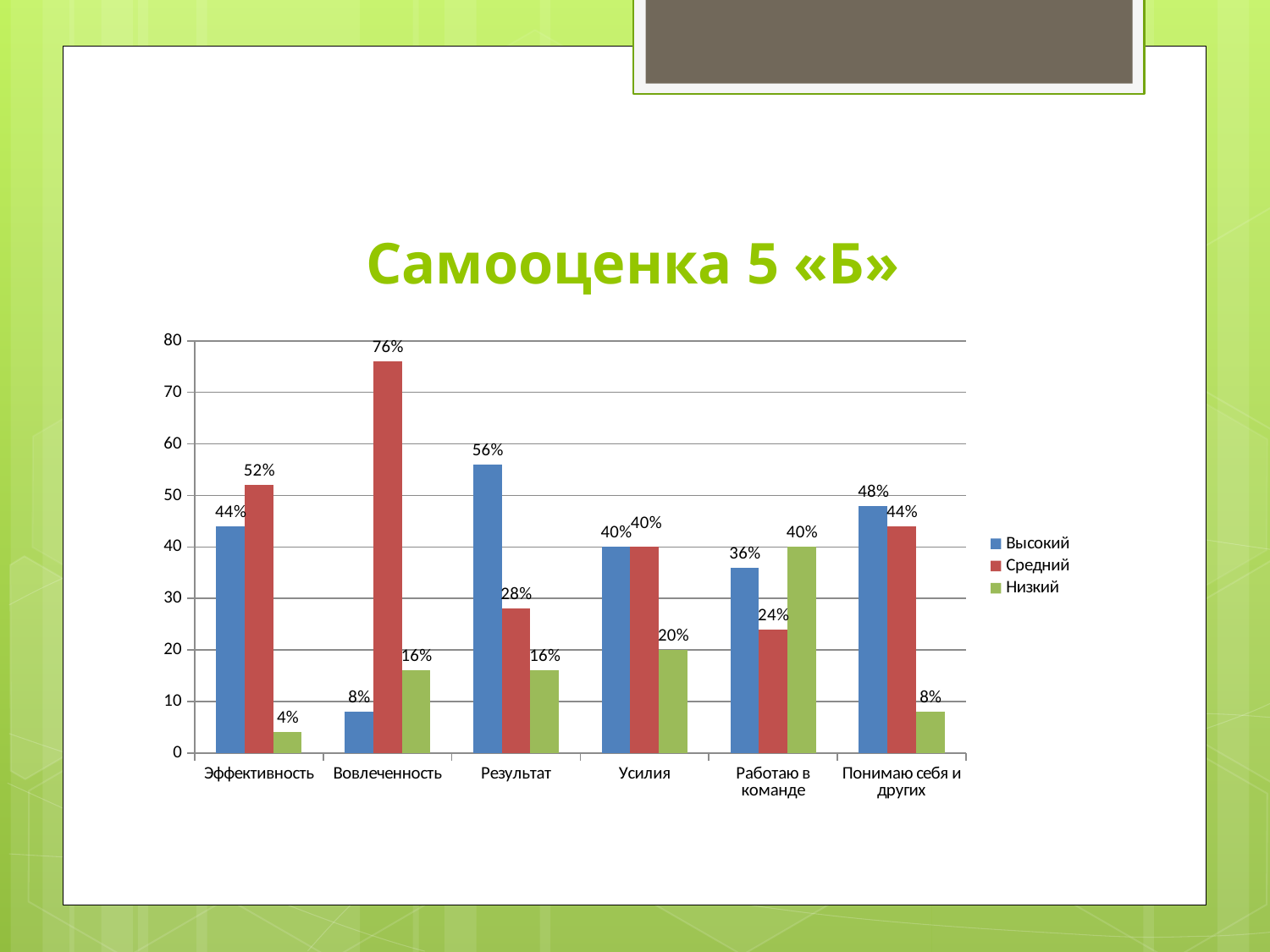
How many categories are shown on the x axis? 6 What is the value of the Высокий series for Результат? 56% What is the value of the Высокий series for Работаю в команде? 36% What is the value of the Средний series for Вовлеченность? 76% Which category has the lowest value in the Высокий series? Вовлеченность How many series does the legend list? 3 What is the difference between the Высокий and Средний values for Понимаю себя и других? 4% For Работаю в команде, which is larger: the Высокий value or the Низкий value? Низкий What kind of chart is shown on the slide? Bar chart What is the title of the chart? Самооценка 5 «Б» What is the value of the Низкий series for Эффективность? 4% Which category has the highest value in the Средний series? Вовлеченность